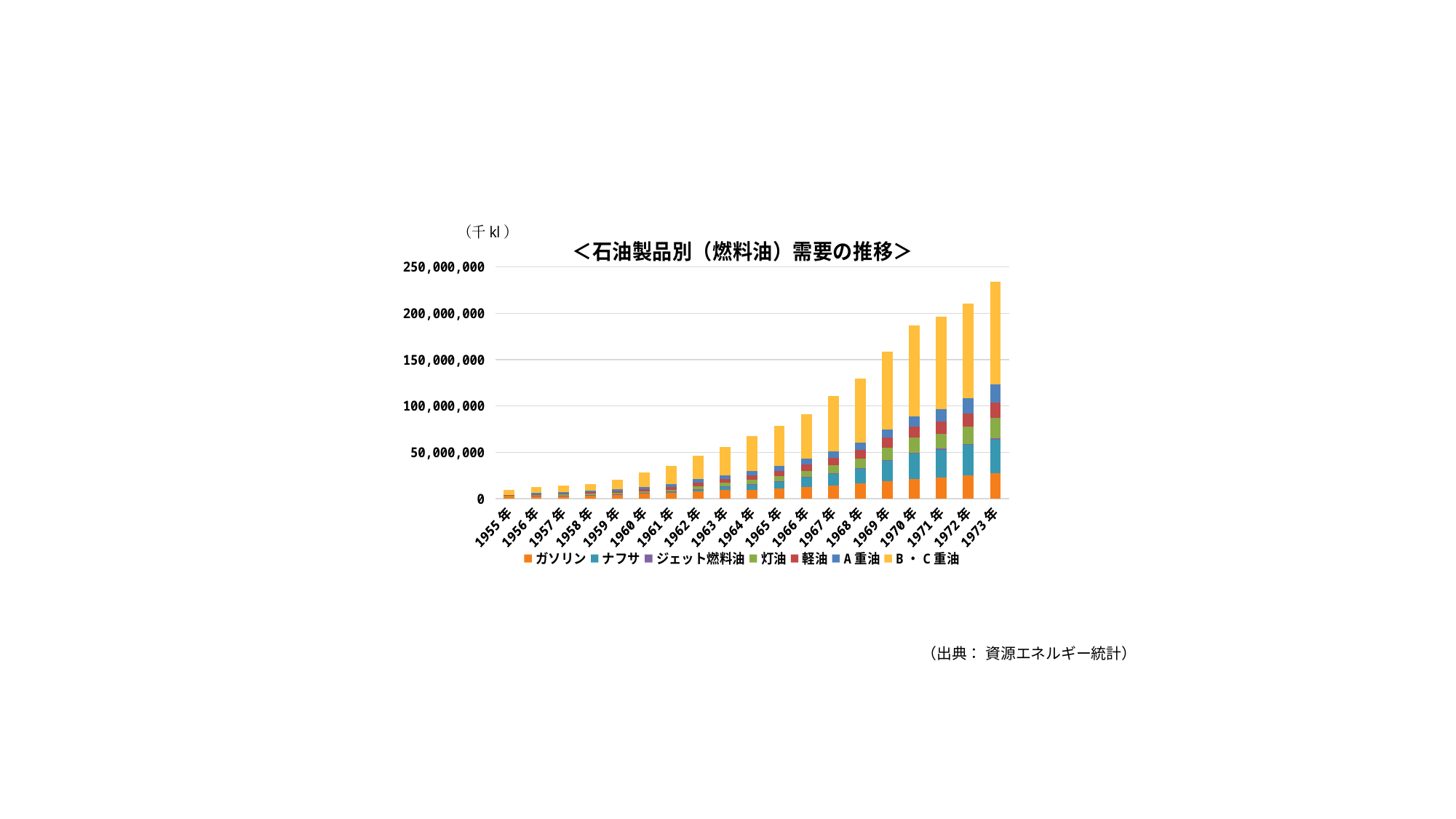
Is the total value for 1960年 greater or less than 50,000,000? less Which year has the lowest total stacked bar? 1955年 Is the total value for 1965年 greater or less than 100,000,000? less How many series does the legend list? 7 Do the total values rise or fall from 1955年 to 1973年? Rise What unit is shown above the y axis of the chart? （千kl） Which year has the larger total stacked bar, 1968年 or 1972年? 1972年 How many years (categories) are plotted along the x axis? 19 Which year has the highest total stacked bar? 1973年 Is the total value for 1973年 greater or less than 200,000,000? greater What is the title of the chart? ＜石油製品別（燃料油）需要の推移＞ What kind of chart is shown on the slide? Stacked bar chart